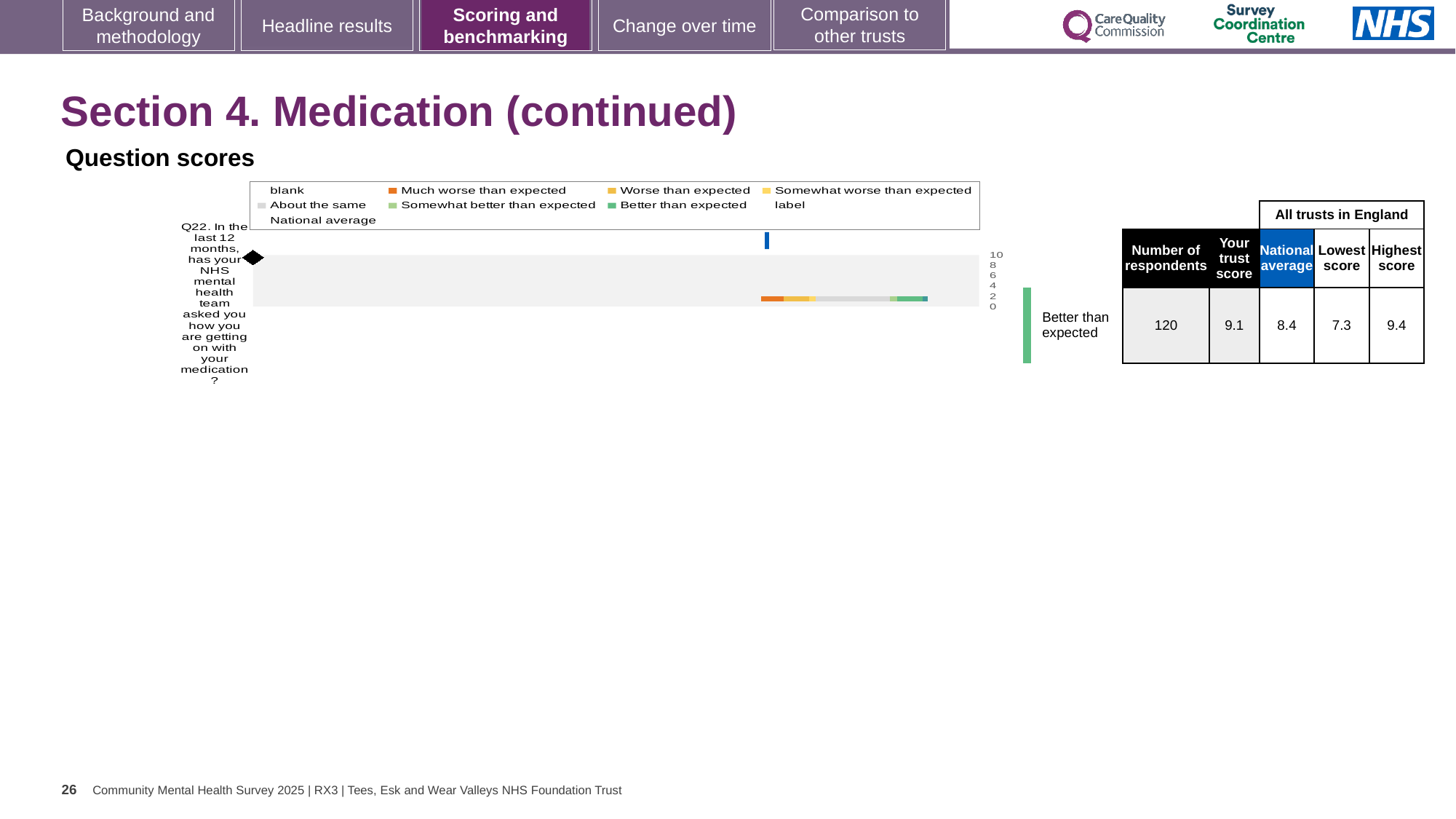
For Q22, what is the difference between the highest and lowest scores among all trusts in England? 2.1 In the table beside the chart, what is the national average for Q22? 8.4 In the table beside the chart, what is the highest score among all trusts in England for Q22? 9.4 How many survey questions are plotted in the Question scores chart? 1 In the table beside the chart, what is the lowest score among all trusts in England for Q22? 7.3 In the table beside the chart, how many respondents answered Q22? 120 In the table beside the chart, what is the trust score for Q22? 9.1 What kind of chart is shown under 'Question scores'? bar chart What rating label is shown to the right of the Question scores chart for Q22? Better than expected Which question number is plotted in the Question scores chart? Q22 For Q22, what is the difference between the trust score and the national average? 0.7 For Q22, which is larger: the trust score or the national average? trust score